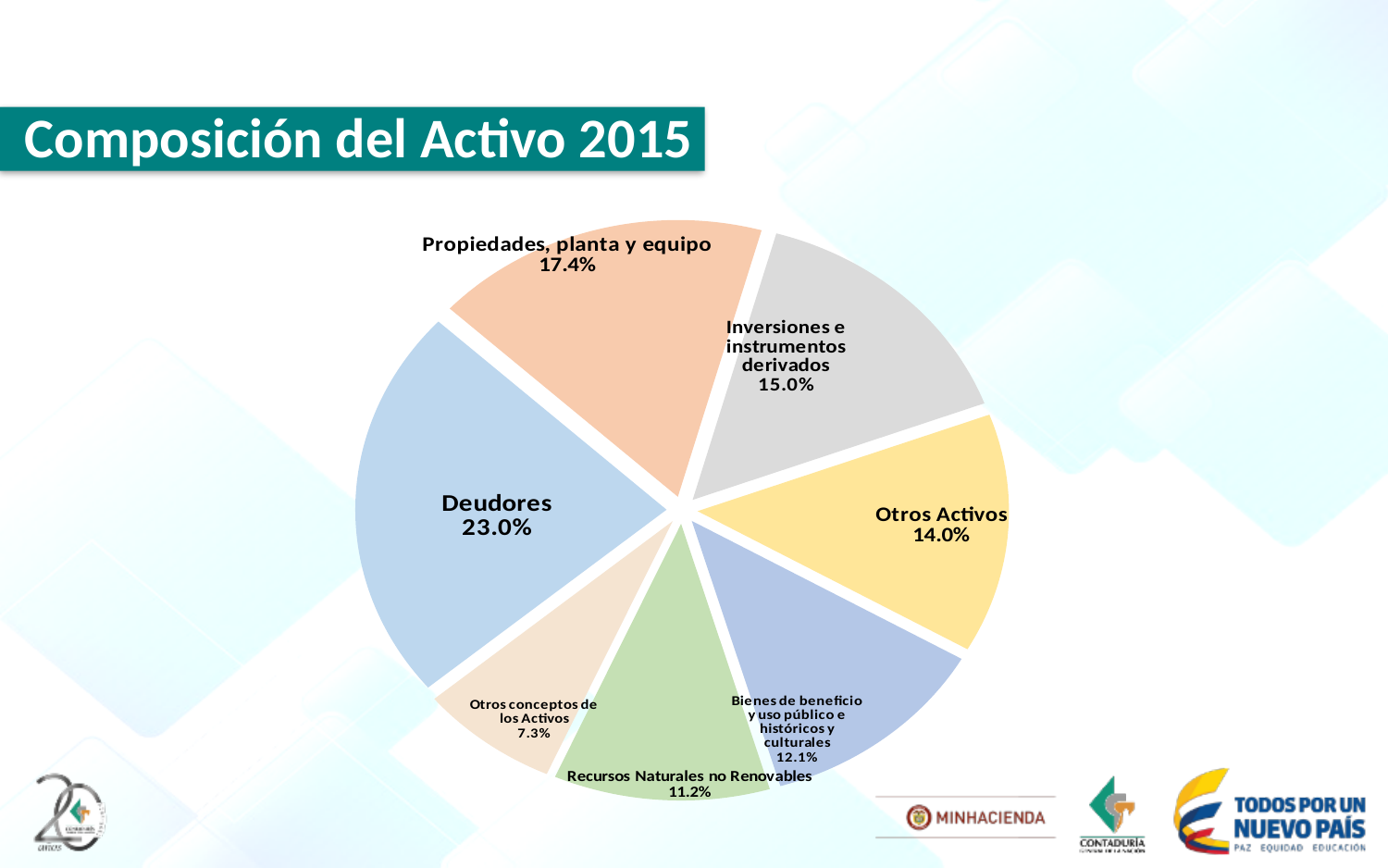
What is the value shown for Propiedades, planta y equipo? 17.4% What kind of chart is shown on the slide? Pie chart Which category has the largest share of the pie? Deudores Which is larger, the share for Bienes de beneficio y uso público e históricos y culturales or the share for Otros conceptos de los Activos? Bienes de beneficio y uso público e históricos y culturales What is the title of the slide's chart? Composición del Activo 2015 Which category has the smallest share of the pie? Otros conceptos de los Activos What share of the pie does Deudores represent? 23.0% How many slices does the pie chart have? 7 What is the value shown for Recursos Naturales no Renovables? 11.2% What is the value shown for Inversiones e instrumentos derivados? 15.0% What is the difference between the shares of Deudores and Otros Activos? 9.0% What is the combined share of Otros Activos and Otros conceptos de los Activos? 21.3%